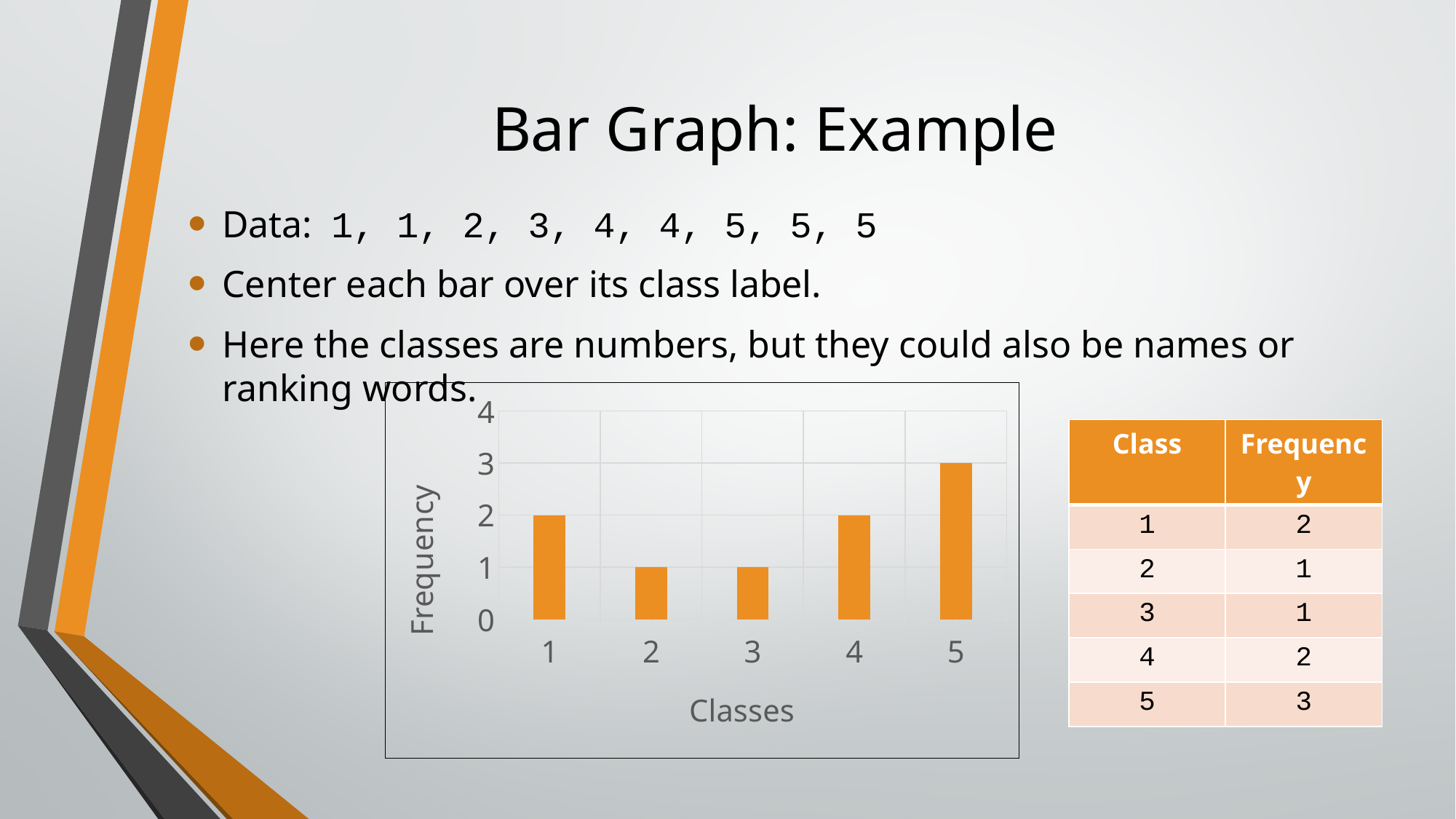
Which class has the highest frequency? 5 What is the frequency for class 5? 3 How many classes are shown on the x axis of the chart? 5 Which has a higher frequency, class 1 or class 3? Class 1 What is the difference in frequency between class 5 and class 2? 2 What is the frequency for class 1? 2 What kind of chart is shown on the slide? Bar chart What is the label of the vertical axis of the chart? Frequency What is the frequency for class 3? 1 What is the label of the horizontal axis of the chart? Classes Do classes 2 and 4 have the same frequency? Yes Is the frequency for class 5 greater or less than 2? greater